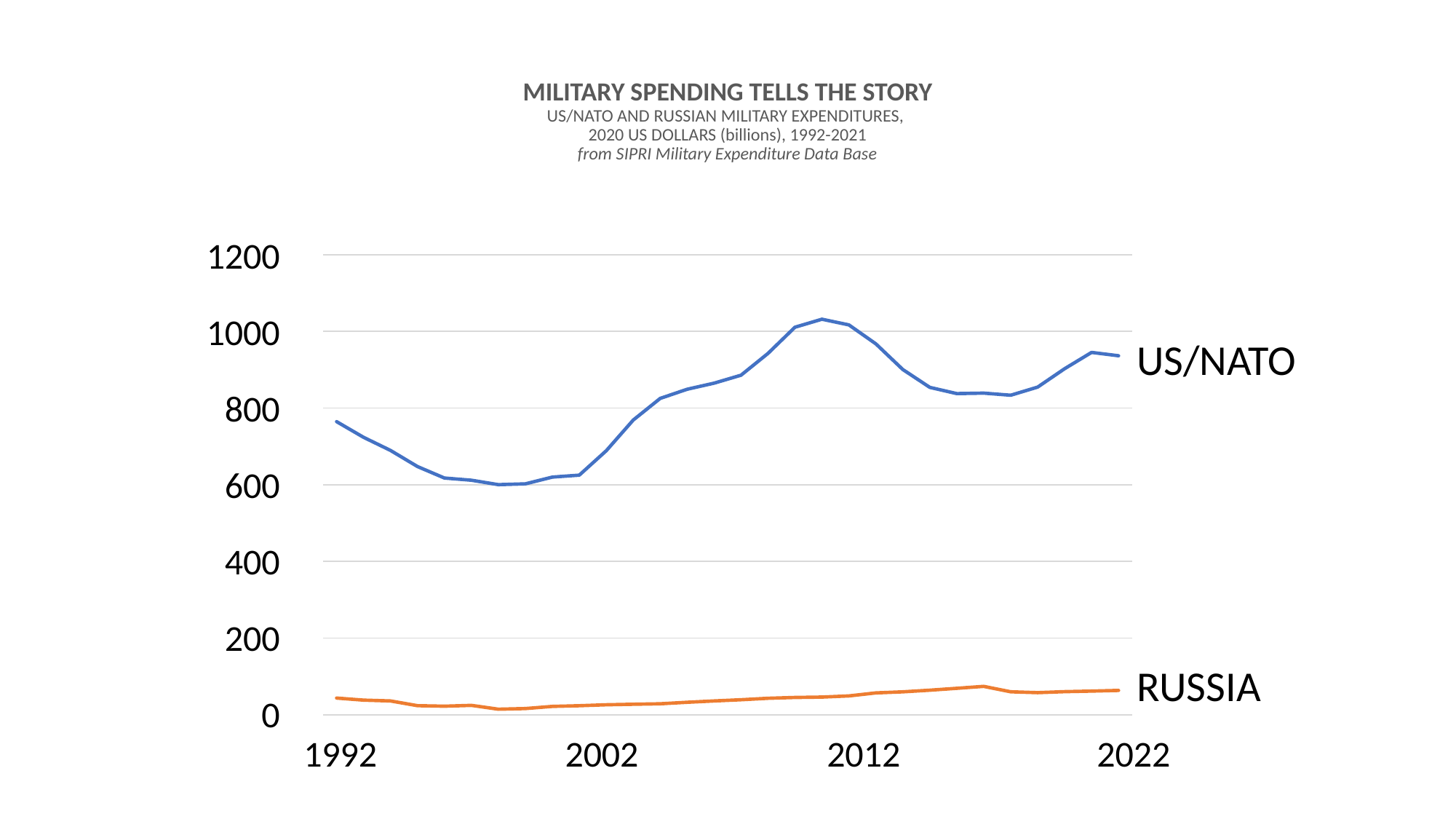
Which series has the higher value in 2012, US/NATO or RUSSIA? US/NATO Is the peak value of the US/NATO line greater or less than 1000? greater What kind of chart is shown on the slide? line chart What is the main title of the chart? MILITARY SPENDING TELLS THE STORY Is the value for US/NATO in 2002 greater or less than 800? less Does the US/NATO line rise or fall between 1992 and 2002? fall Which series is drawn with the orange line? RUSSIA How many series are plotted on the chart? 2 Which series has the higher value in 1992, US/NATO or RUSSIA? US/NATO Does the RUSSIA line rise or fall between 2002 and 2012? rise Is the value for US/NATO in 1992 greater or less than 600? greater